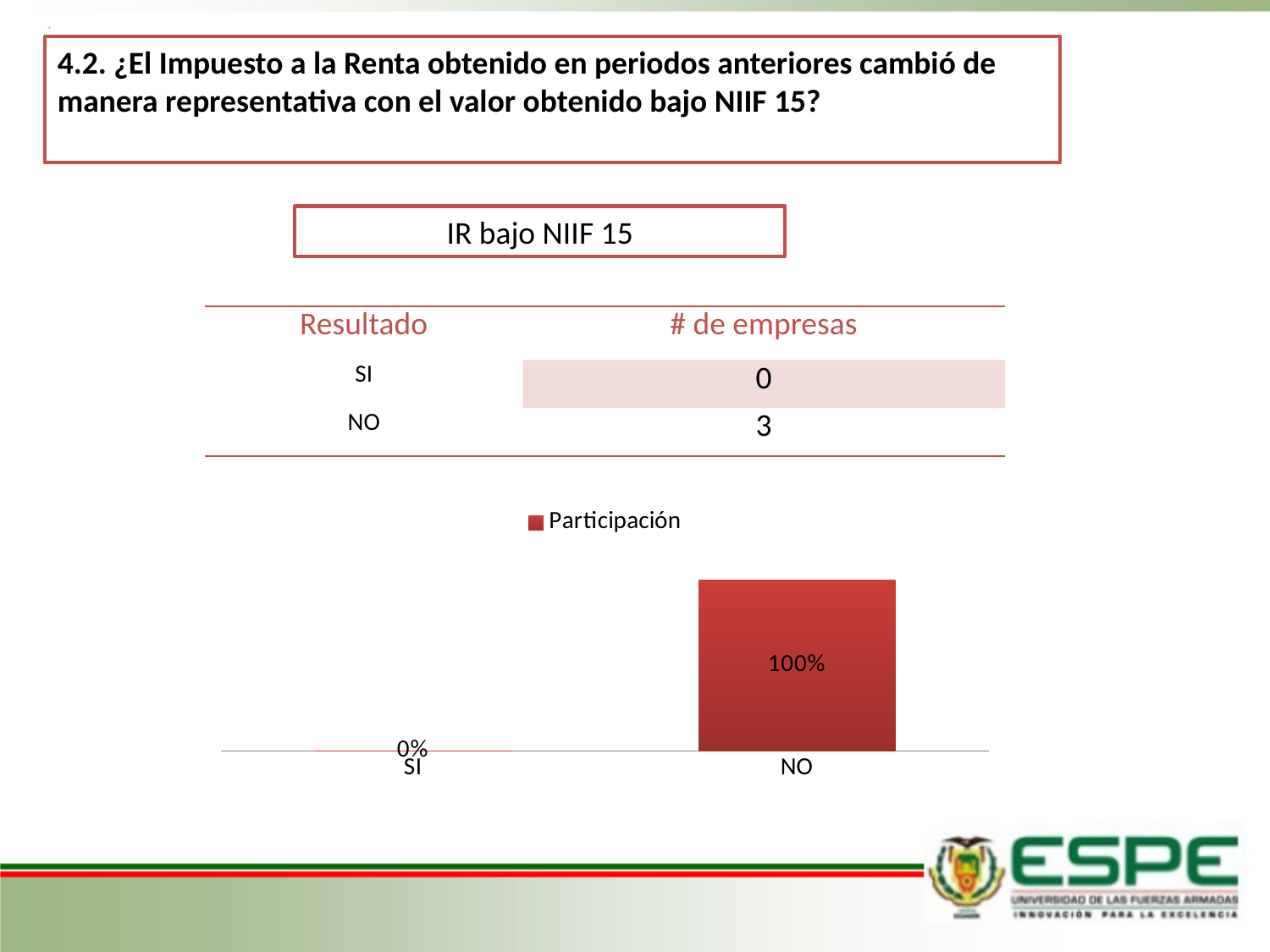
Which is larger in the chart, the value for SI or the value for NO? NO What colour is the bar in the chart? red What is the name of the series shown in the chart legend? Participación Which category has the highest value in the chart? NO How many categories are shown on the x axis of the chart? 2 What is the value for NO in the chart? 100% What kind of chart is shown on the slide? bar chart Which category has the lowest value in the chart? SI What is the value for SI in the chart? 0% Do the values rise or fall from SI to NO along the x axis? rise What is the difference between the values for NO and SI in the chart? 100% How many series does the chart legend list? 1